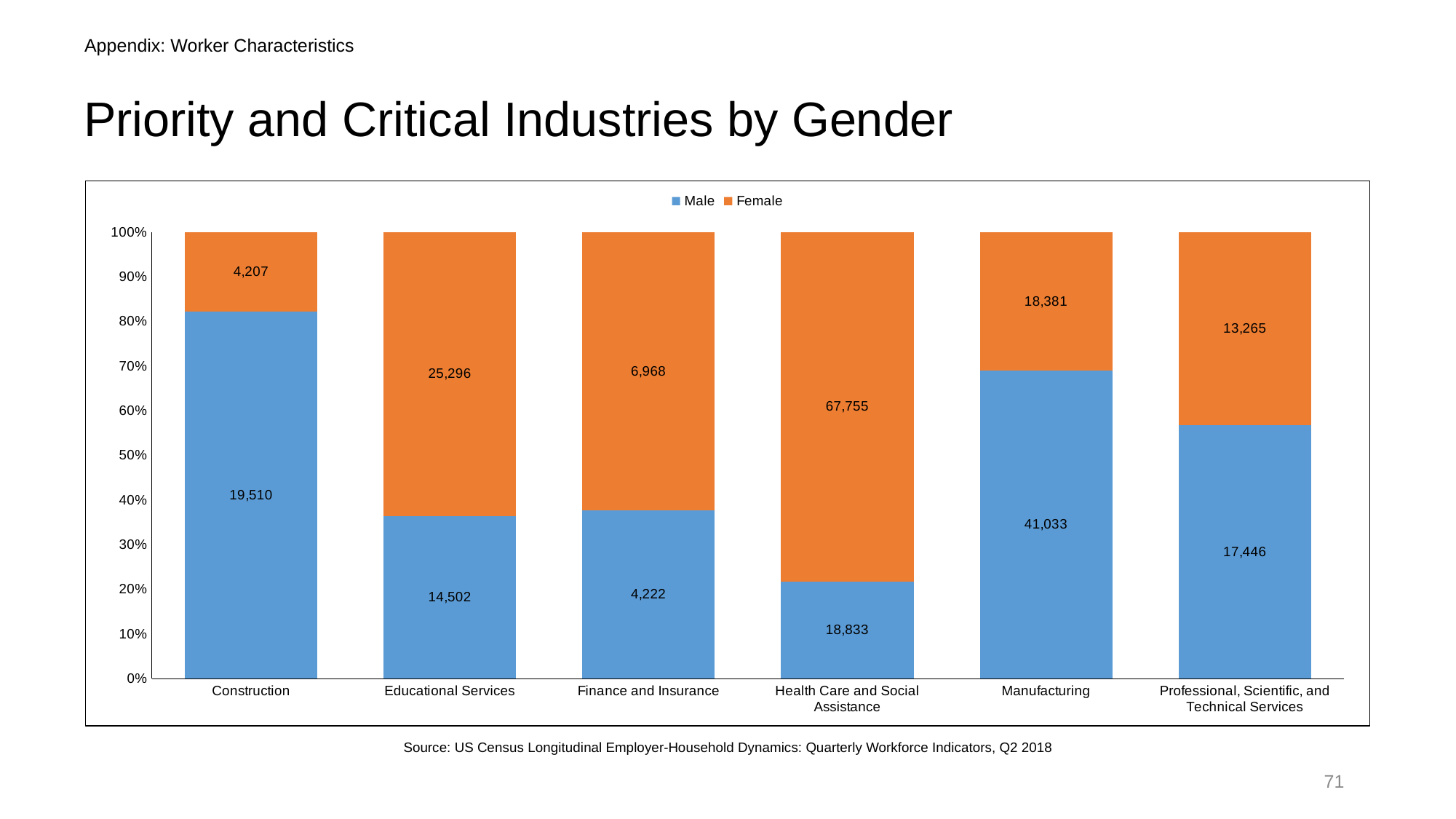
What is the total of the Male and Female values for Finance and Insurance? 11,190 How many industries are shown on the x axis? 6 What is the Female value for Health Care and Social Assistance? 67,755 What kind of chart is shown on the slide? Stacked bar chart Which industry has the highest Female value? Health Care and Social Assistance What is the Male value for Manufacturing? 41,033 What is the difference between the Male and Female values for Manufacturing? 22,652 Which industry has the lowest Male value? Finance and Insurance Which is larger for Educational Services, the Male value or the Female value? Female What is the Female value for Construction? 4,207 How many series does the legend list? 2 Is the Male share of the Construction bar greater or less than 80%? greater